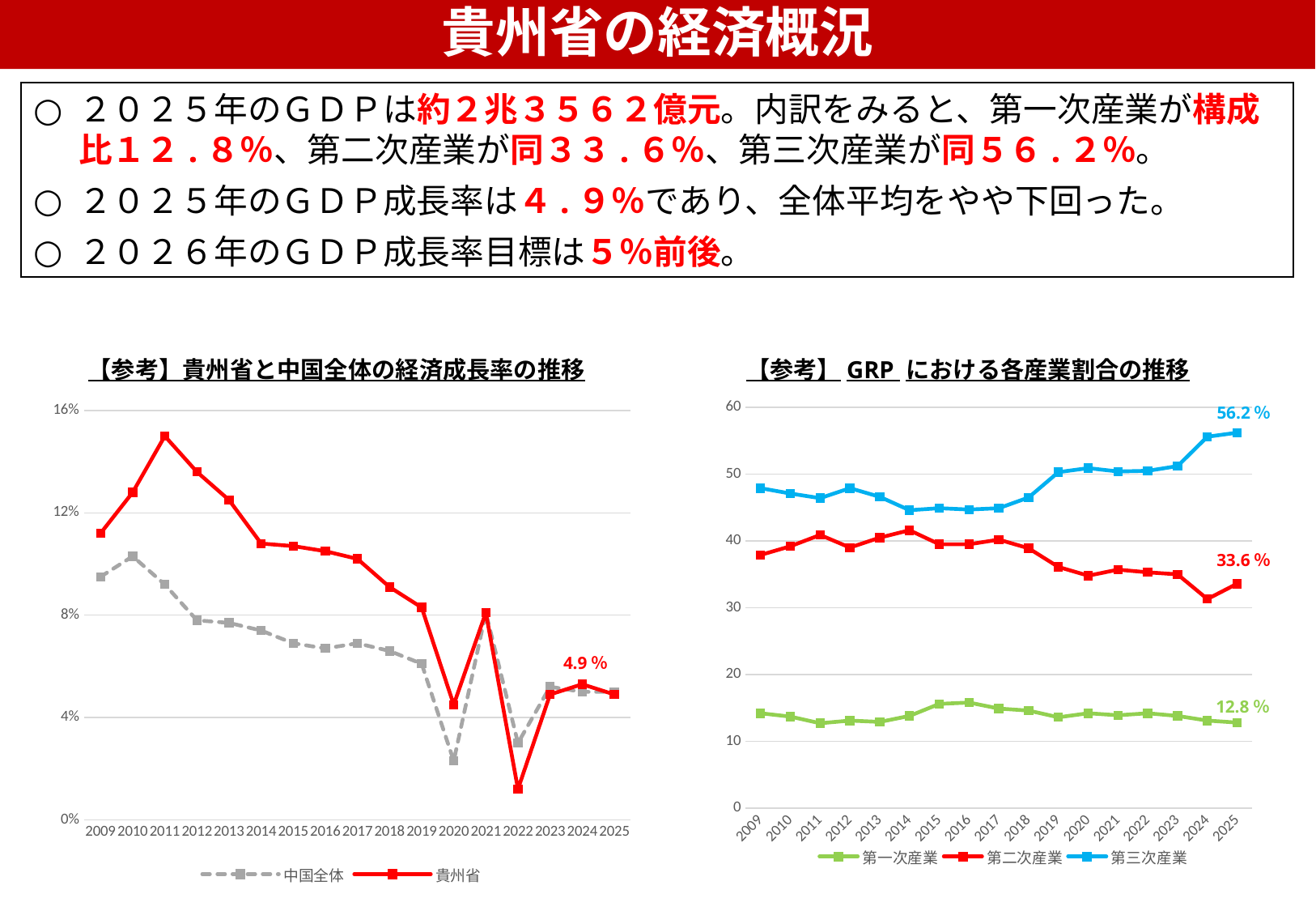
In the left chart (貴州省と中国全体の経済成長率の推移), is the value for 貴州省 in 2011 greater or less than 12%? greater In the right chart (GRPにおける各産業割合の推移), what is the value for 第二次産業 in 2025? 33.6％ In the right chart (GRPにおける各産業割合の推移), what is the value for 第三次産業 in 2025? 56.2％ In the right chart (GRPにおける各産業割合の推移), what is the value for 第一次産業 in 2025? 12.8％ In the right chart (GRPにおける各産業割合の推移), what is the difference between the 2025 values of 第三次産業 and 第二次産業? 22.6％ How many years are shown on the x axis of the left chart (貴州省と中国全体の経済成長率の推移)? 17 In the right chart (GRPにおける各産業割合の推移), which industry has the highest share in 2025? 第三次産業 How many series does the legend of the right chart (GRPにおける各産業割合の推移) list? 3 How many series does the legend of the left chart (貴州省と中国全体の経済成長率の推移) list? 2 In the left chart (貴州省と中国全体の経済成長率の推移), which is larger in 2011, 貴州省 or 中国全体? 貴州省 What kind of chart is the left chart, 【参考】貴州省と中国全体の経済成長率の推移? line chart In the left chart (貴州省と中国全体の経済成長率の推移), what is the labelled value for 貴州省 in 2025? 4.9％